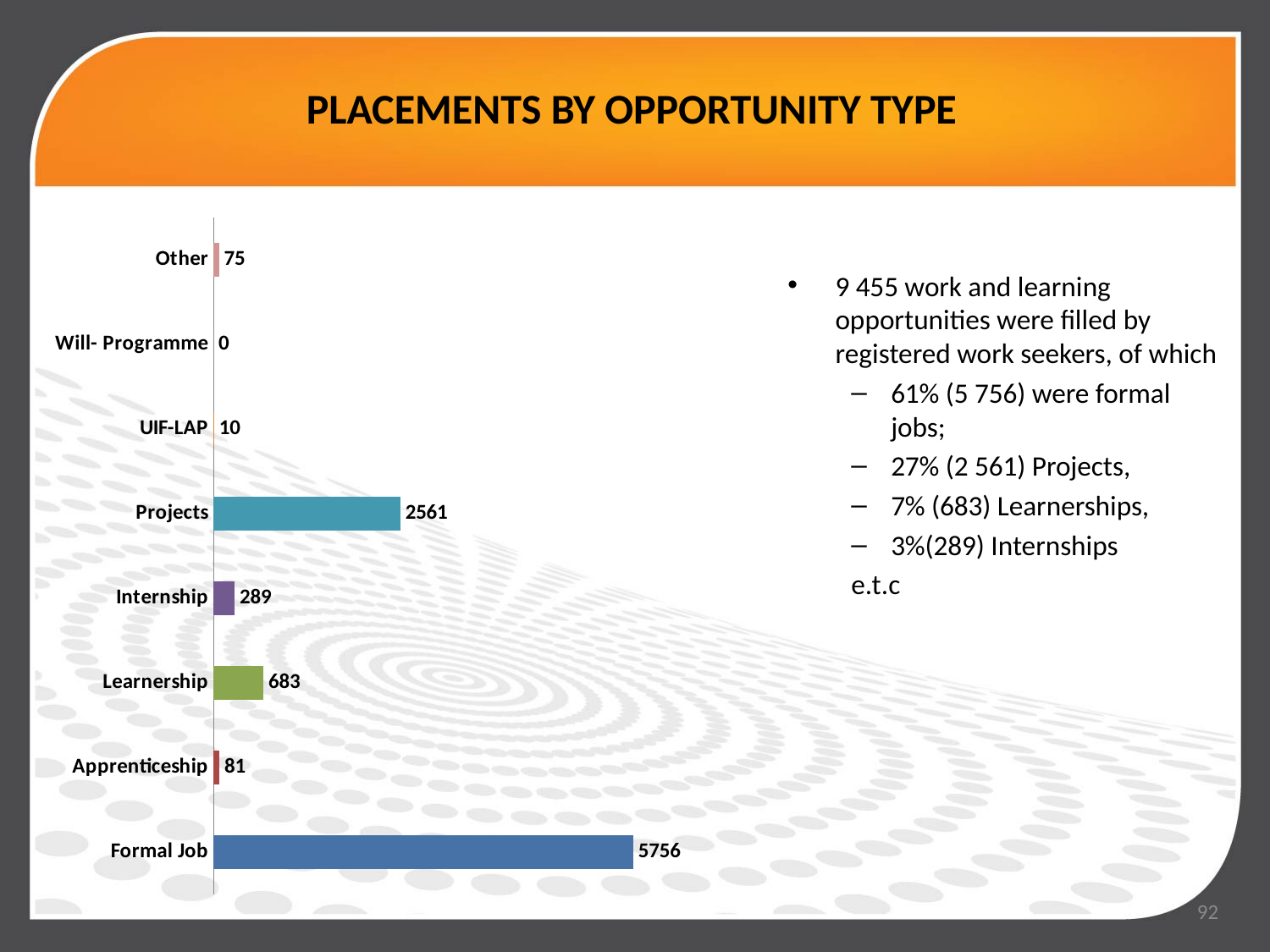
What is the value for Learnership? 683 Which category has the highest value? Formal Job What is the title of the slide containing the chart? PLACEMENTS BY OPPORTUNITY TYPE What is the value for Will- Programme? 0 What is the difference between the values for Formal Job and Projects? 3195 What is the value for Formal Job? 5756 How many categories are shown in the chart? 8 What is the difference between the values for Internship and Apprenticeship? 208 What is the value for Projects? 2561 Which category has the lowest value? Will- Programme Which is larger, the value for Learnership or the value for Internship? Learnership What kind of chart is shown on the slide? bar chart